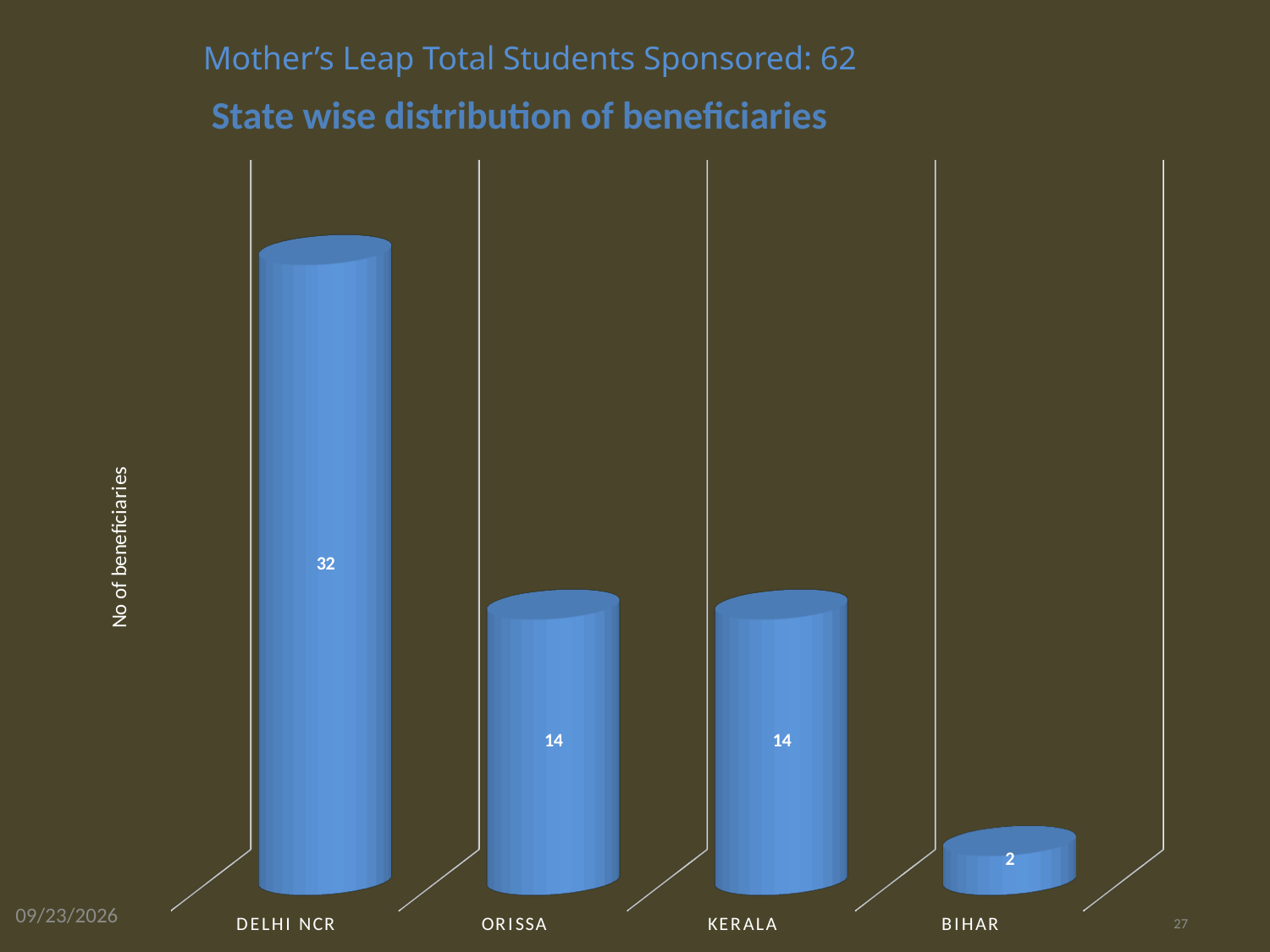
What is the title of the chart? State wise distribution of beneficiaries What is the number of beneficiaries for Orissa? 14 Which has more beneficiaries, Delhi NCR or Orissa? Delhi NCR Which state has the highest number of beneficiaries? Delhi NCR How many states are shown in the chart? 4 What is the difference in beneficiaries between Delhi NCR and Kerala? 18 What is the number of beneficiaries for Bihar? 2 What kind of chart is shown on the slide? Bar chart What is the label of the vertical axis? No of beneficiaries Which state has the lowest number of beneficiaries? Bihar What is the number of beneficiaries for Delhi NCR? 32 What is the difference in beneficiaries between Orissa and Bihar? 12